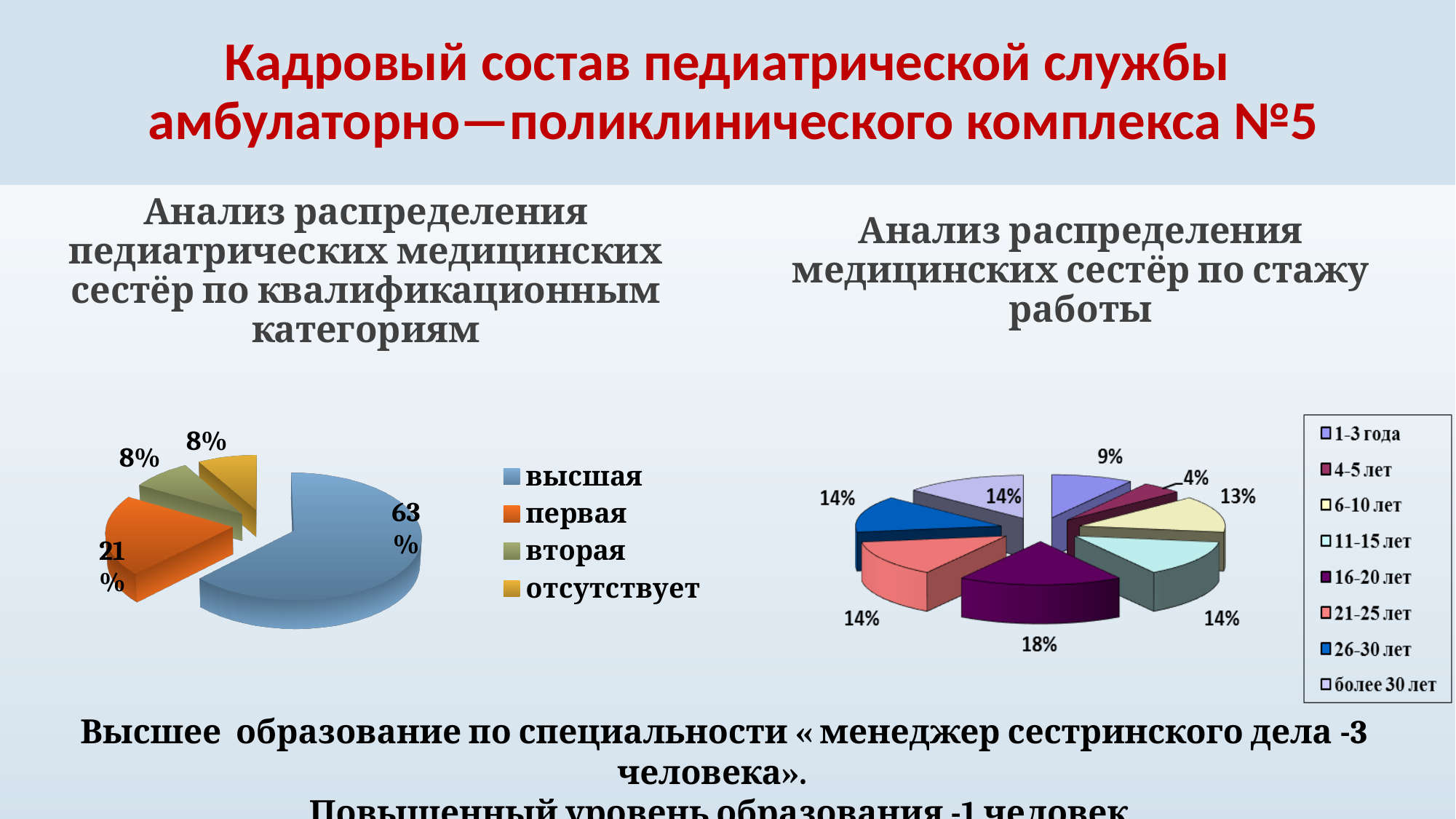
In the left pie chart on qualification categories, what share of nurses have the 'первая' category? 21% In the right pie chart on work experience, what share of nurses have 4-5 лет of experience? 4% In the left pie chart on qualification categories, what share of nurses have the 'высшая' category? 63% In the right pie chart on work experience, which is larger: the share for 6-10 лет or the share for 1-3 года? 6-10 лет What type of chart is used for the analysis of nurses by work experience (right chart)? pie chart In the right pie chart on work experience, what share of nurses have 16-20 лет of experience? 18% In the right pie chart on work experience, how many experience groups does the legend list? 8 In the right pie chart on work experience, which experience group has the largest share? 16-20 лет In the left pie chart on qualification categories, which category has the largest share? высшая In the right pie chart on work experience, which experience group has the smallest share? 4-5 лет In the left pie chart on qualification categories, what is the difference between the 'высшая' and 'первая' shares? 42% In the left pie chart on qualification categories, how many categories does the legend list? 4